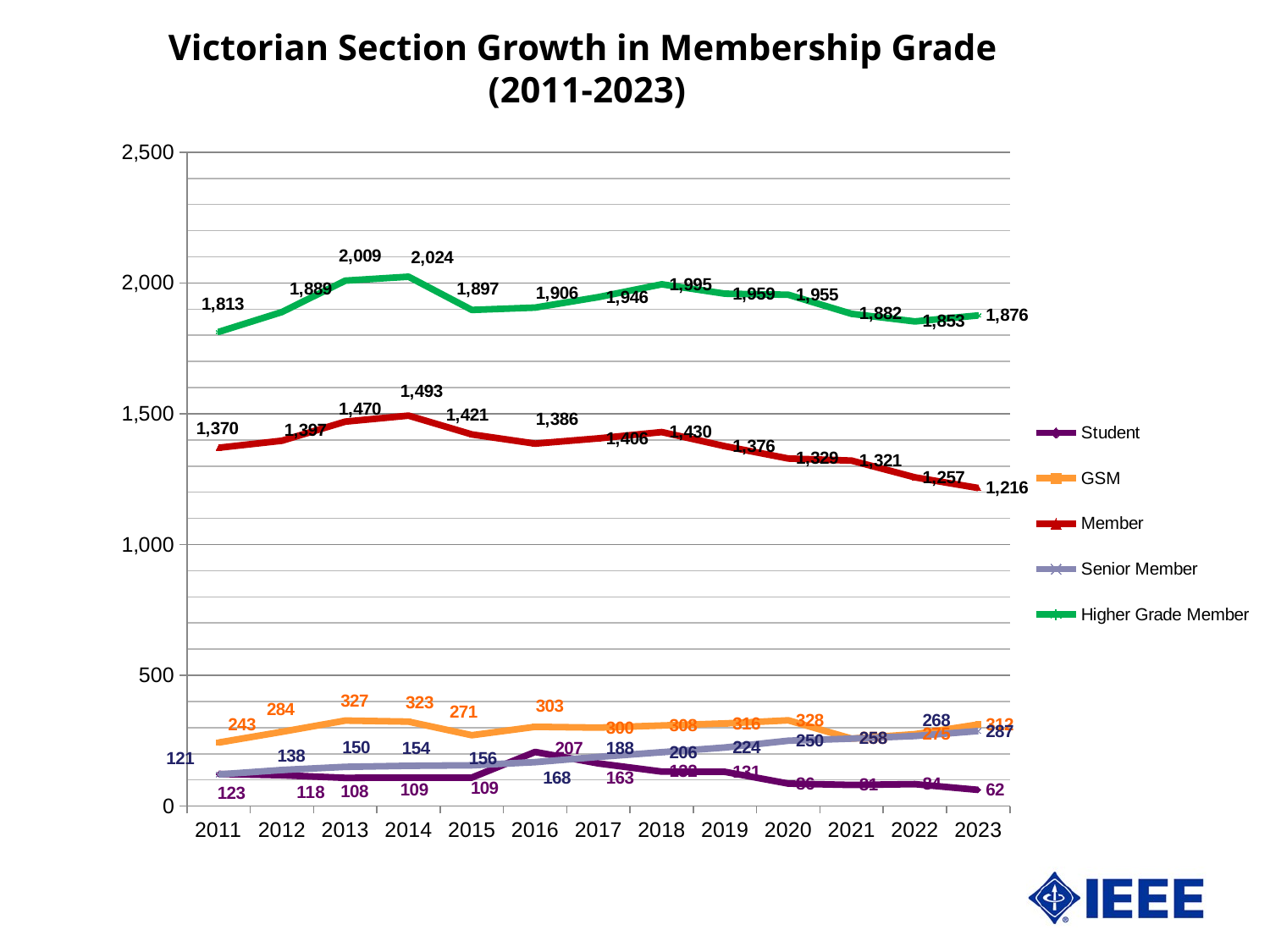
What is the difference between the Member value in 2011 and in 2023? 154 In which year is the Member series at its lowest? 2023 Which is larger in 2013, the GSM value or the Senior Member value? GSM How many years are plotted along the x axis? 13 Does the Senior Member series generally rise or fall from 2011 to 2023? rise How many series does the legend list? 5 What is the Student value for 2016? 207 In which year does the Higher Grade Member series reach its highest value? 2014 What kind of chart is shown on the slide? line chart What is the Higher Grade Member value for 2014? 2,024 Is the Higher Grade Member value for 2011 greater or less than 2,000? less What is the Member value for 2023? 1,216